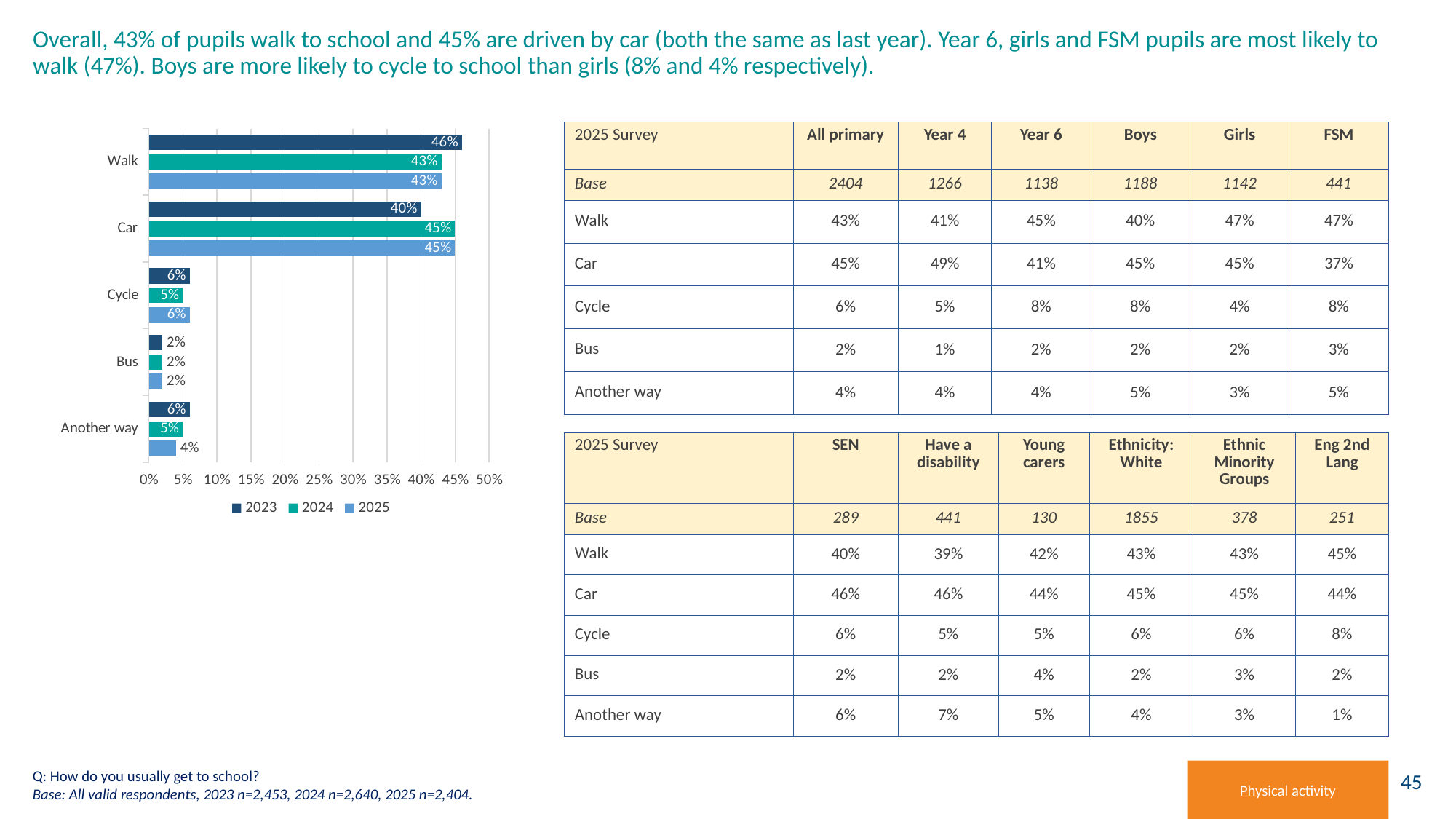
Which series is shown in the darkest blue colour? 2023 What is the value for Car in 2025? 45% What is the value for Another way in 2025? 4% What kind of chart is shown on the slide? bar chart What is the value for Walk in 2023? 46% Which category has the highest value in 2023? Walk What is the value for Cycle in 2024? 5% What is the difference between the 2023 and 2025 values for Walk? 3% How many series does the chart's legend list? 3 How many categories are shown on the chart? 5 Which is larger for 2024: Walk or Car? Car Which category has the lowest value in 2025? Bus